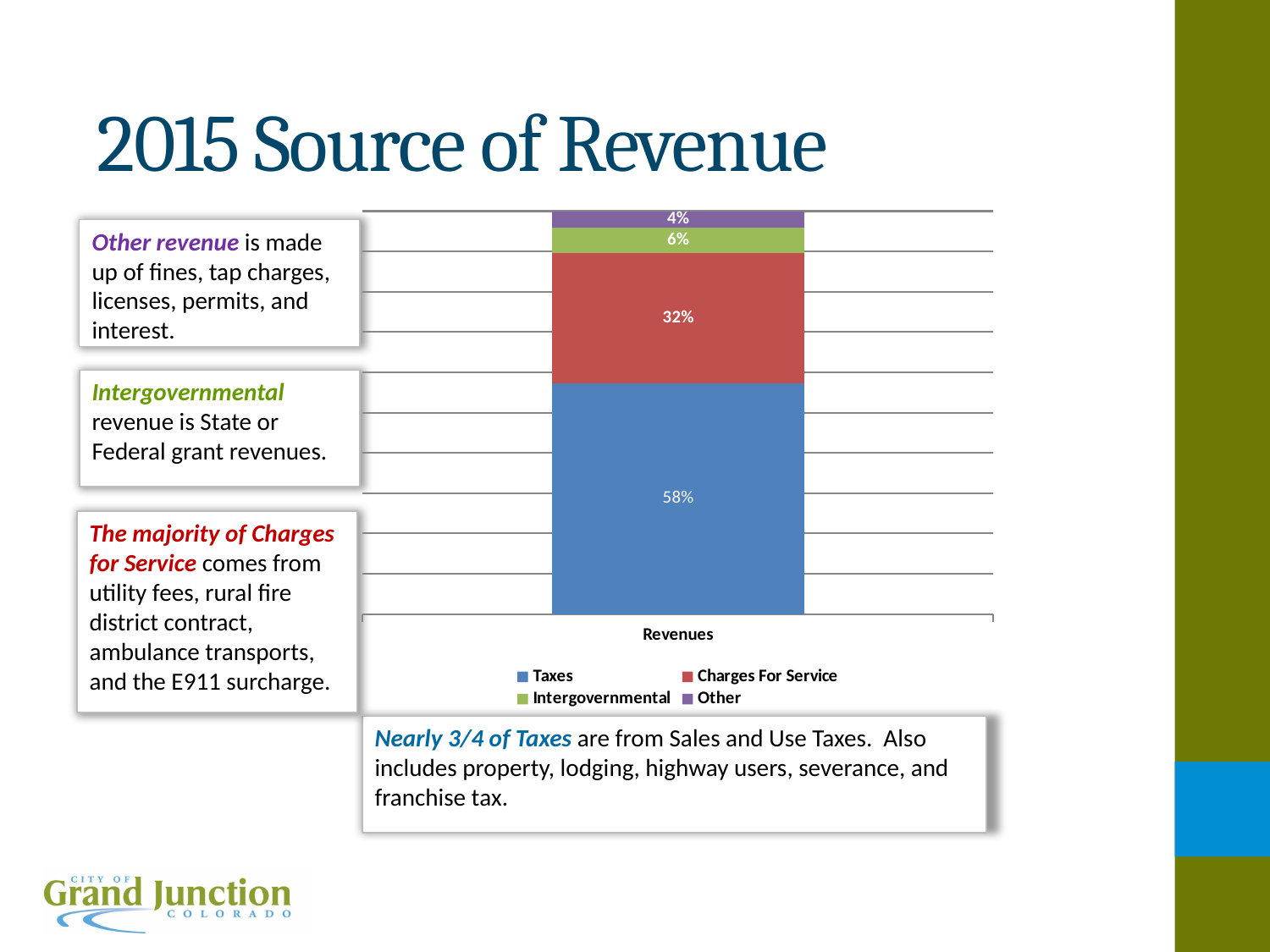
What is the total of the four segments in the stacked bar? 100% What is the label on the x axis under the bar? Revenues What percentage of revenue comes from Other sources? 4% What percentage of revenue comes from Taxes? 58% Which revenue source makes up the largest share of the stacked bar? Taxes Which revenue source makes up the smallest share of the stacked bar? Other Which is larger, the Intergovernmental share or the Other share? Intergovernmental What kind of chart is shown on the slide? Stacked bar chart What is the difference in percentage points between Taxes and Charges For Service? 26 What percentage of revenue comes from Charges For Service? 32% How many series does the legend list? 4 What percentage of revenue comes from Intergovernmental sources? 6%